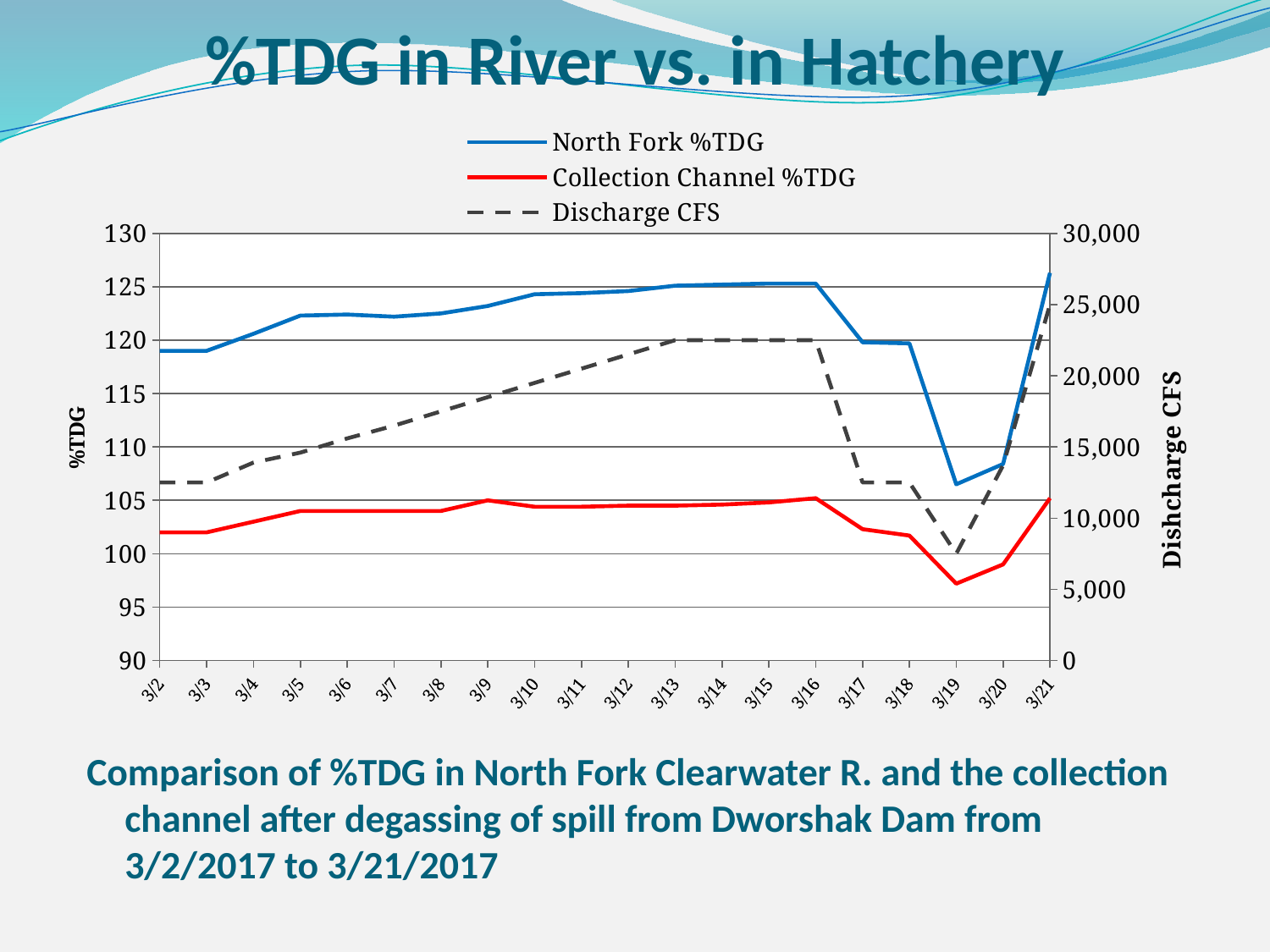
Does the Discharge CFS rise or fall from 3/16 to 3/19? fall Is the North Fork %TDG value on 3/16 greater or less than 120? greater What kind of chart is shown on the slide? line chart On 3/10, which is higher: North Fork %TDG or Collection Channel %TDG? North Fork %TDG On which date is the North Fork %TDG at its lowest? 3/19 Is the Discharge CFS value on 3/19 greater or less than 10,000? less Which series is drawn with a red line? Collection Channel %TDG How many dates are plotted along the x axis? 20 Is the Discharge CFS value on 3/13 greater or less than 20,000? greater How many series does the legend list? 3 On which date is the Collection Channel %TDG at its lowest? 3/19